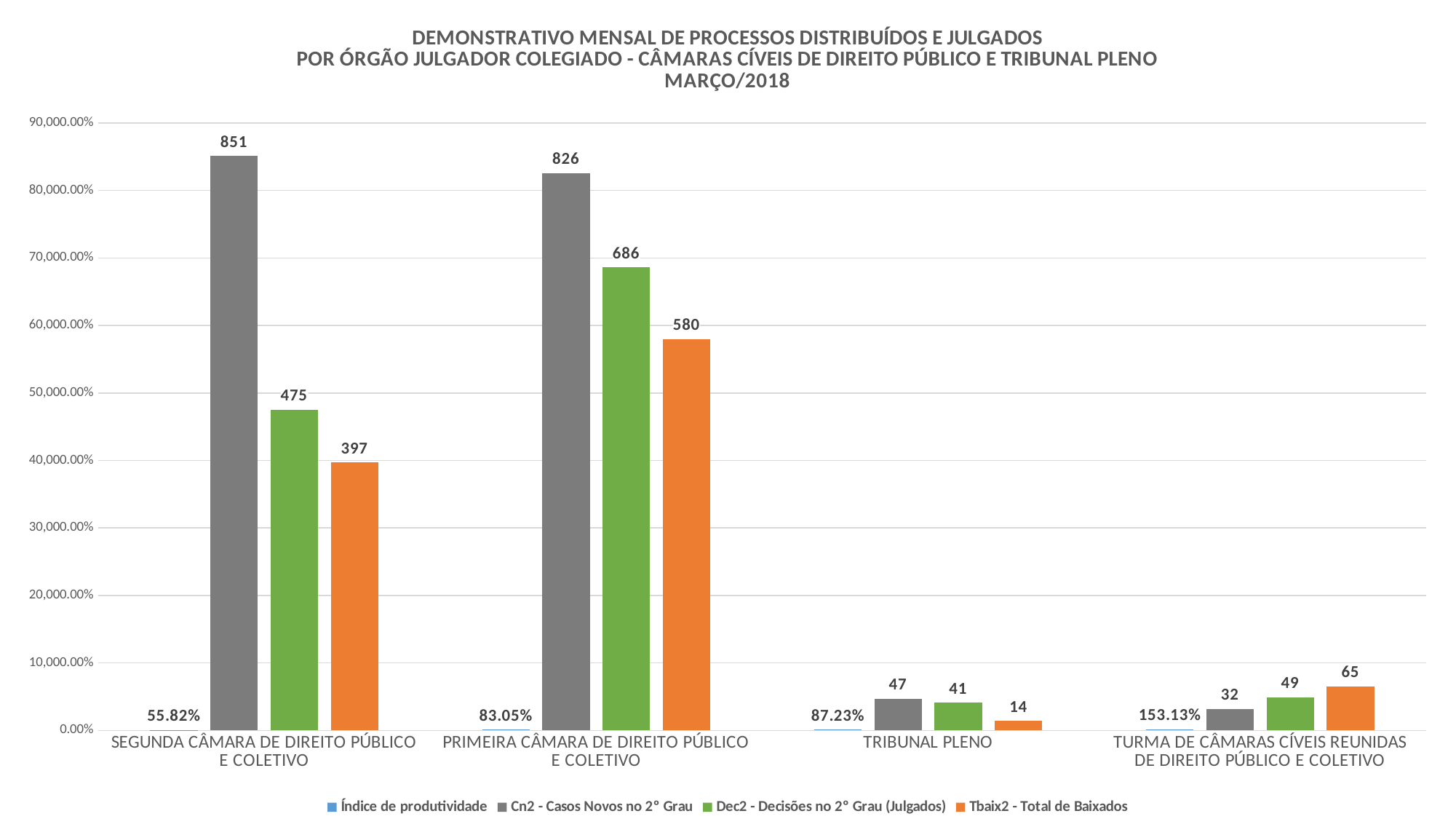
How many categories are shown on the x axis? 4 What is the value of Dec2 - Decisões no 2° Grau (Julgados) for TURMA DE CÂMARAS CÍVEIS REUNIDAS DE DIREITO PÚBLICO E COLETIVO? 49 How many series does the legend list? 4 Which category has the lowest Tbaix2 - Total de Baixados value? TRIBUNAL PLENO What is the Índice de produtividade for TRIBUNAL PLENO? 87.23% Which category has the highest Cn2 - Casos Novos no 2° Grau value? SEGUNDA CÂMARA DE DIREITO PÚBLICO E COLETIVO What is the value of Cn2 - Casos Novos no 2° Grau for SEGUNDA CÂMARA DE DIREITO PÚBLICO E COLETIVO? 851 What kind of chart is shown on the slide? Bar chart Which category has the highest Índice de produtividade? TURMA DE CÂMARAS CÍVEIS REUNIDAS DE DIREITO PÚBLICO E COLETIVO What is the value of Tbaix2 - Total de Baixados for PRIMEIRA CÂMARA DE DIREITO PÚBLICO E COLETIVO? 580 Which is larger for PRIMEIRA CÂMARA DE DIREITO PÚBLICO E COLETIVO: Dec2 - Decisões no 2° Grau (Julgados) or Tbaix2 - Total de Baixados? Dec2 - Decisões no 2° Grau (Julgados) What is the difference between Cn2 - Casos Novos no 2° Grau and Dec2 - Decisões no 2° Grau (Julgados) for SEGUNDA CÂMARA DE DIREITO PÚBLICO E COLETIVO? 376